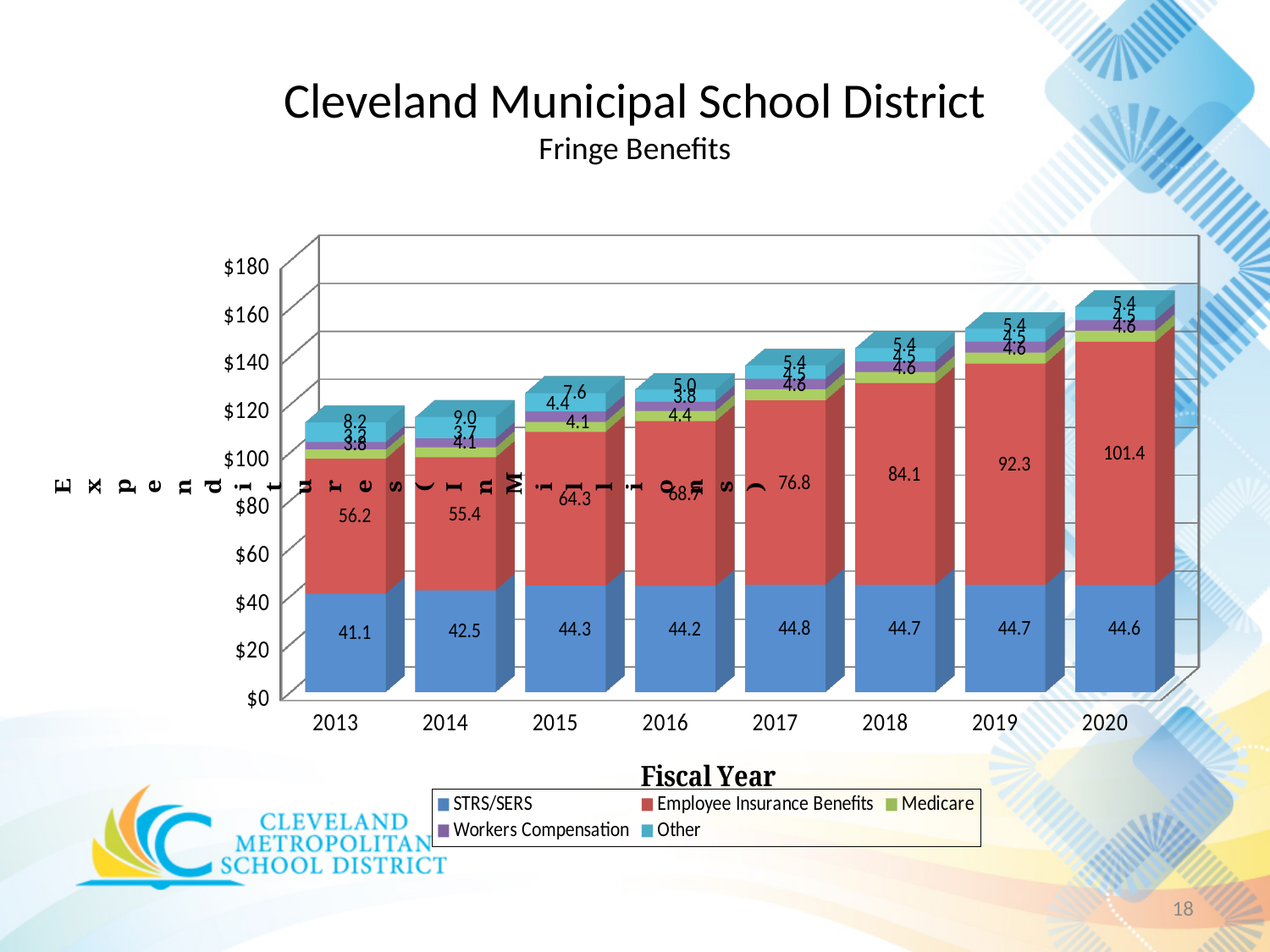
What is the value of Employee Insurance Benefits for fiscal year 2020? 101.4 What kind of chart is shown on the slide? stacked bar chart In which fiscal year is STRS/SERS lowest? 2013 What is the value of the Other series for fiscal year 2014? 9.0 In which fiscal year is Employee Insurance Benefits highest? 2020 How many series does the legend list? 5 Is the total height of the 2020 stacked bar greater or less than $140? greater What is the value of STRS/SERS for fiscal year 2013? 41.1 What is the difference between Employee Insurance Benefits in 2020 and in 2013? 45.2 How many fiscal years are shown on the x axis? 8 Which is larger, STRS/SERS in 2017 or in 2014? 2017 Does Employee Insurance Benefits rise or fall from 2015 to 2020? rise